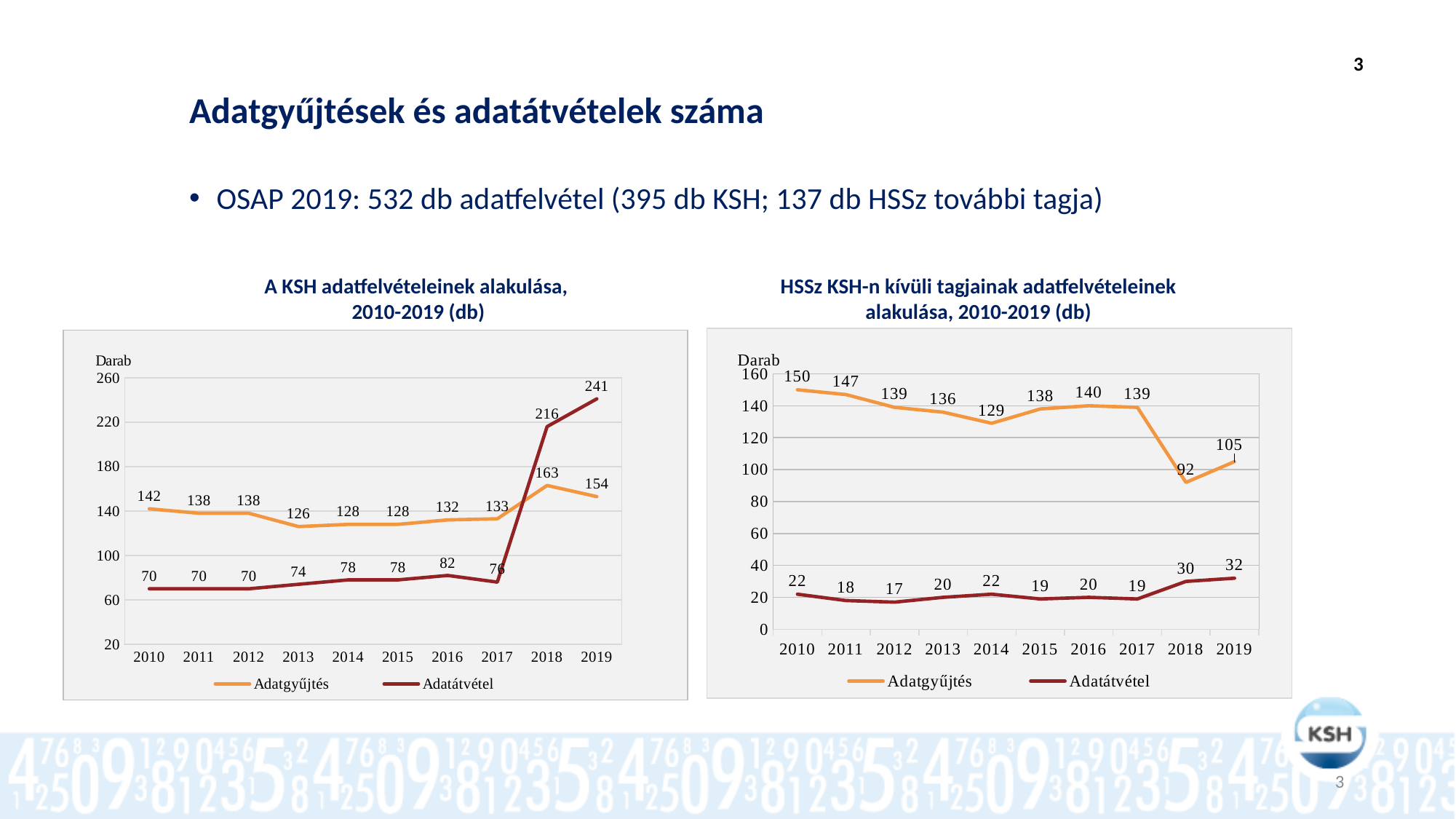
In the chart titled 'A KSH adatfelvételeinek alakulása, 2010-2019 (db)', which series has the larger value in 2019, Adatgyűjtés or Adatátvétel? Adatátvétel In the chart titled 'HSSz KSH-n kívüli tagjainak adatfelvételeinek alakulása, 2010-2019 (db)', what is the difference between the Adatgyűjtés values for 2010 and 2019? 45 In the chart titled 'HSSz KSH-n kívüli tagjainak adatfelvételeinek alakulása, 2010-2019 (db)', does the Adatgyűjtés series rise or fall from 2017 to 2018? Fall In the chart titled 'A KSH adatfelvételeinek alakulása, 2010-2019 (db)', what is the difference between the Adatátvétel values for 2019 and 2018? 25 In the chart titled 'HSSz KSH-n kívüli tagjainak adatfelvételeinek alakulása, 2010-2019 (db)', what is the Adatgyűjtés value for 2018? 92 In the chart titled 'A KSH adatfelvételeinek alakulása, 2010-2019 (db)', what is the Adatgyűjtés value for 2013? 126 In the chart titled 'A KSH adatfelvételeinek alakulása, 2010-2019 (db)', how many series does the legend list? 2 In the chart titled 'HSSz KSH-n kívüli tagjainak adatfelvételeinek alakulása, 2010-2019 (db)', in which year is the Adatátvétel series lowest? 2012 In the chart titled 'HSSz KSH-n kívüli tagjainak adatfelvételeinek alakulása, 2010-2019 (db)', how many years are shown on the x axis? 10 In the chart titled 'A KSH adatfelvételeinek alakulása, 2010-2019 (db)', in which year is the Adatgyűjtés series highest? 2018 What kind of chart is the chart titled 'HSSz KSH-n kívüli tagjainak adatfelvételeinek alakulása, 2010-2019 (db)'? Line chart In the chart titled 'A KSH adatfelvételeinek alakulása, 2010-2019 (db)', what is the Adatátvétel value for 2019? 241